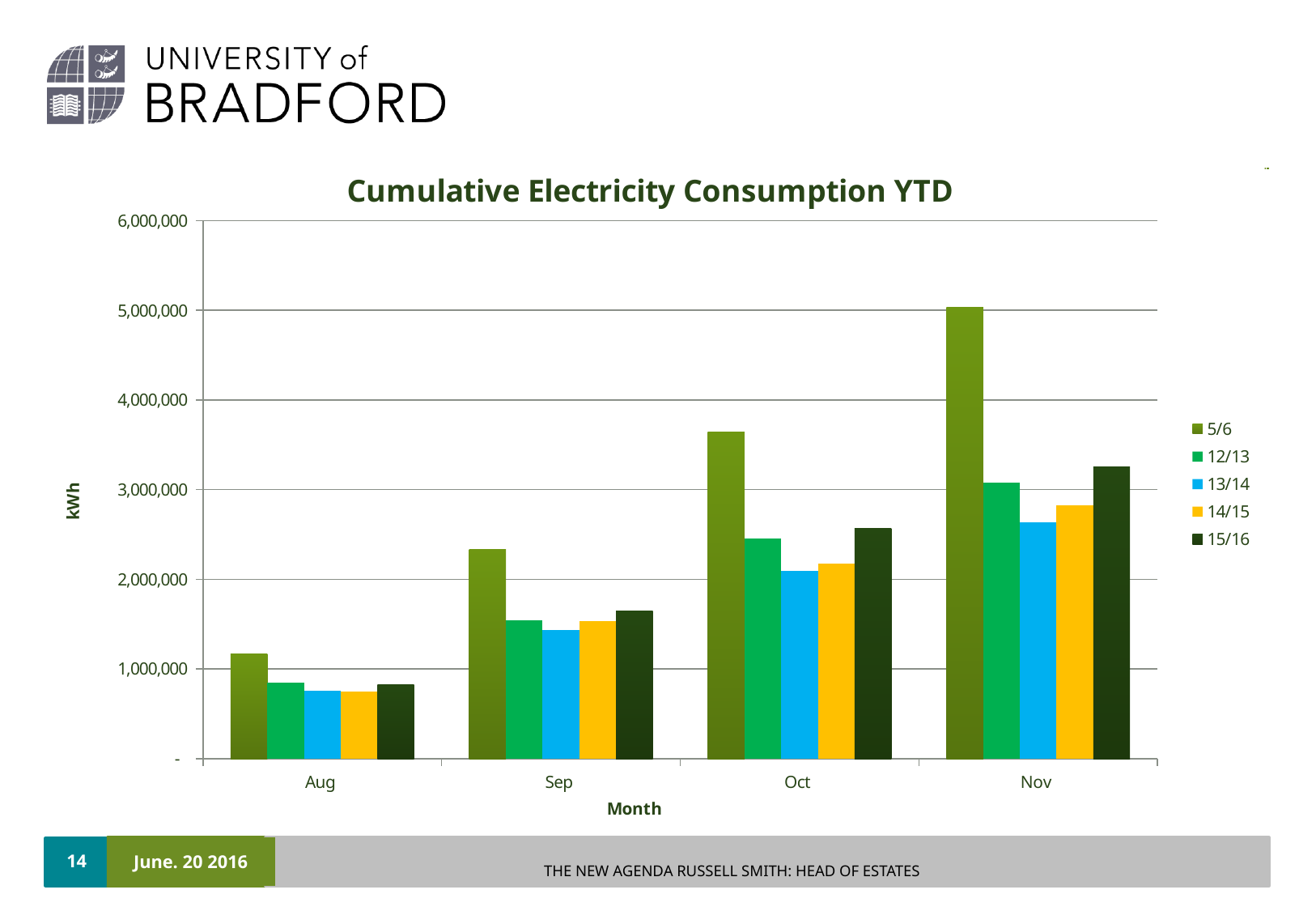
In Nov, which series has the lowest value? 13/14 What is the title of the chart? Cumulative Electricity Consumption YTD Is the value for 15/16 in Oct greater or less than 3,000,000? less In Oct, which is larger: the 15/16 value or the 13/14 value? 15/16 How many series does the legend list? 5 Is the value for 5/6 in Sep greater or less than 2,000,000? greater What kind of chart is shown on the slide? bar chart What is the label on the y axis? kWh In which month is the 5/6 series highest? Nov How many months are shown on the x axis? 4 Does the 5/6 series rise or fall from Aug to Nov? rise Is the value for 5/6 in Nov greater or less than 4,000,000? greater